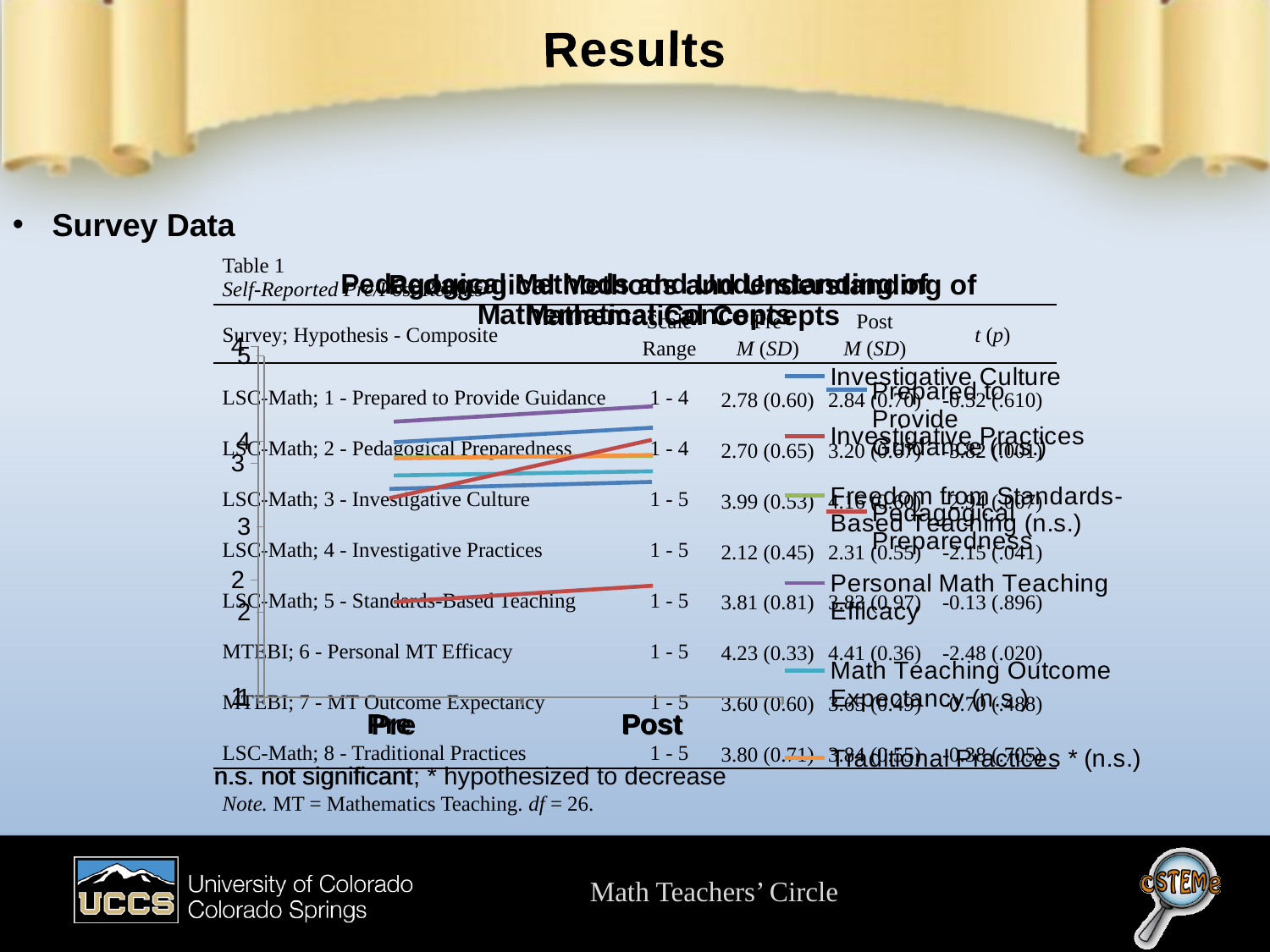
Which series has the lowest line on the chart? Investigative Practices What kind of chart is shown on the slide? line chart Which series has the highest line on the chart? Personal Math Teaching Efficacy How many points are there along the x axis of the chart? 2 Is the Pre value for Investigative Practices greater or less than 3? less Does the line for Pedagogical Preparedness rise or fall from Pre to Post? rise How many series does the chart's legend list? 8 Which is larger on the chart, the Post value for Personal Math Teaching Efficacy or the Post value for Investigative Practices? Personal Math Teaching Efficacy What are the two categories on the x axis of the chart? Pre and Post Is the Post value for Personal Math Teaching Efficacy greater or less than 3? greater Which legend entry is marked with an asterisk as hypothesized to decrease? Traditional Practices